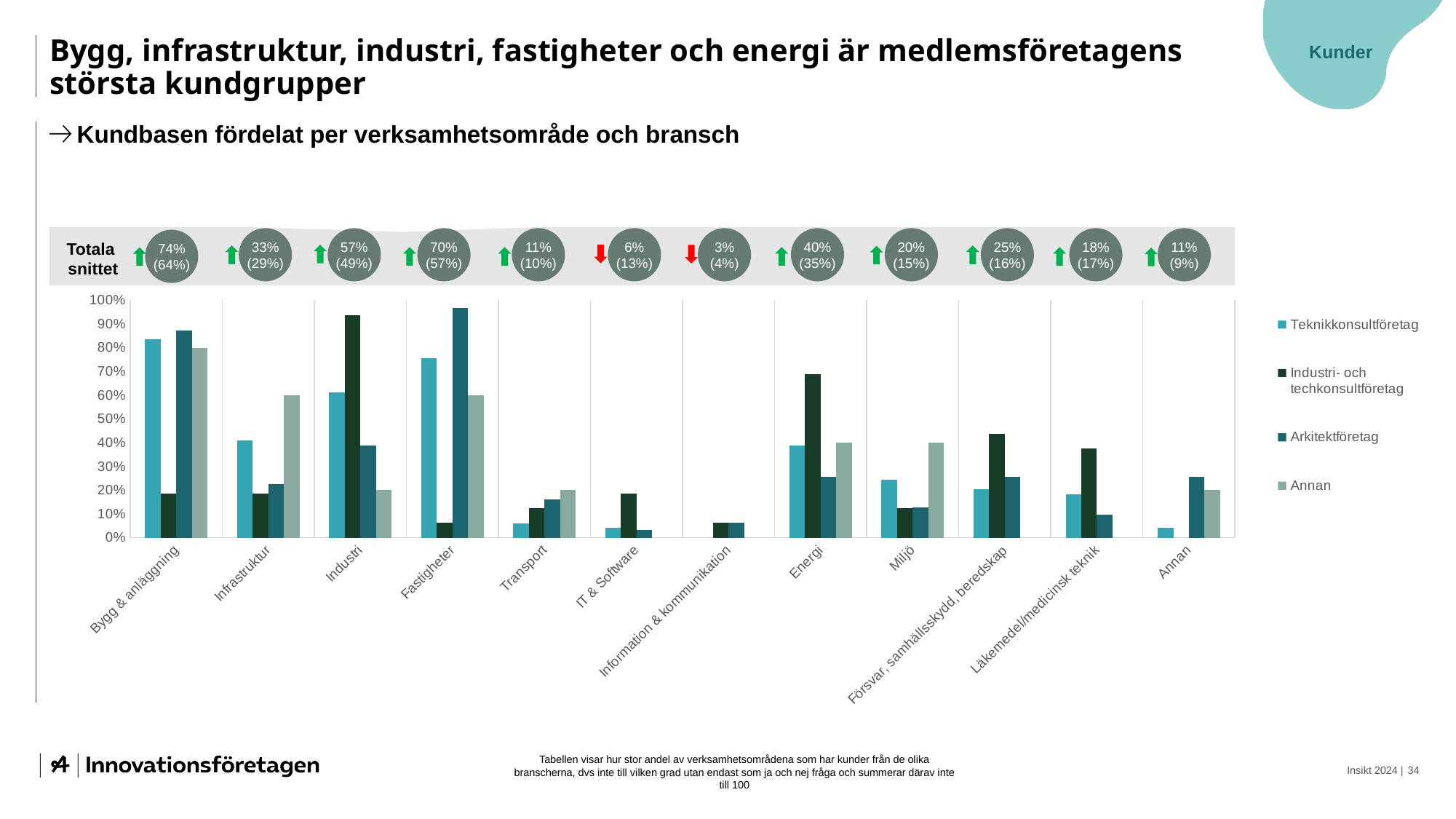
Which series has the highest value in the Industri category? Industri- och techkonsultföretag Is the value for Teknikkonsultföretag in Bygg & anläggning greater or less than 70%? greater Is the value for Industri- och techkonsultföretag in Energi greater or less than 60%? greater How many categories are shown along the x axis of the chart? 12 How many series does the legend list? 4 Is the value for Industri- och techkonsultföretag in Industri greater or less than 80%? greater What is the 'Totala snittet' value shown above the Bygg & anläggning category? 74% (64%) What kind of chart is shown on the slide? Bar chart Which series has the highest value in the Fastigheter category? Arkitektföretag In the Miljö category, which is larger: Annan or Industri- och techkonsultföretag? Annan In the Infrastruktur category, which is larger: Annan or Teknikkonsultföretag? Annan